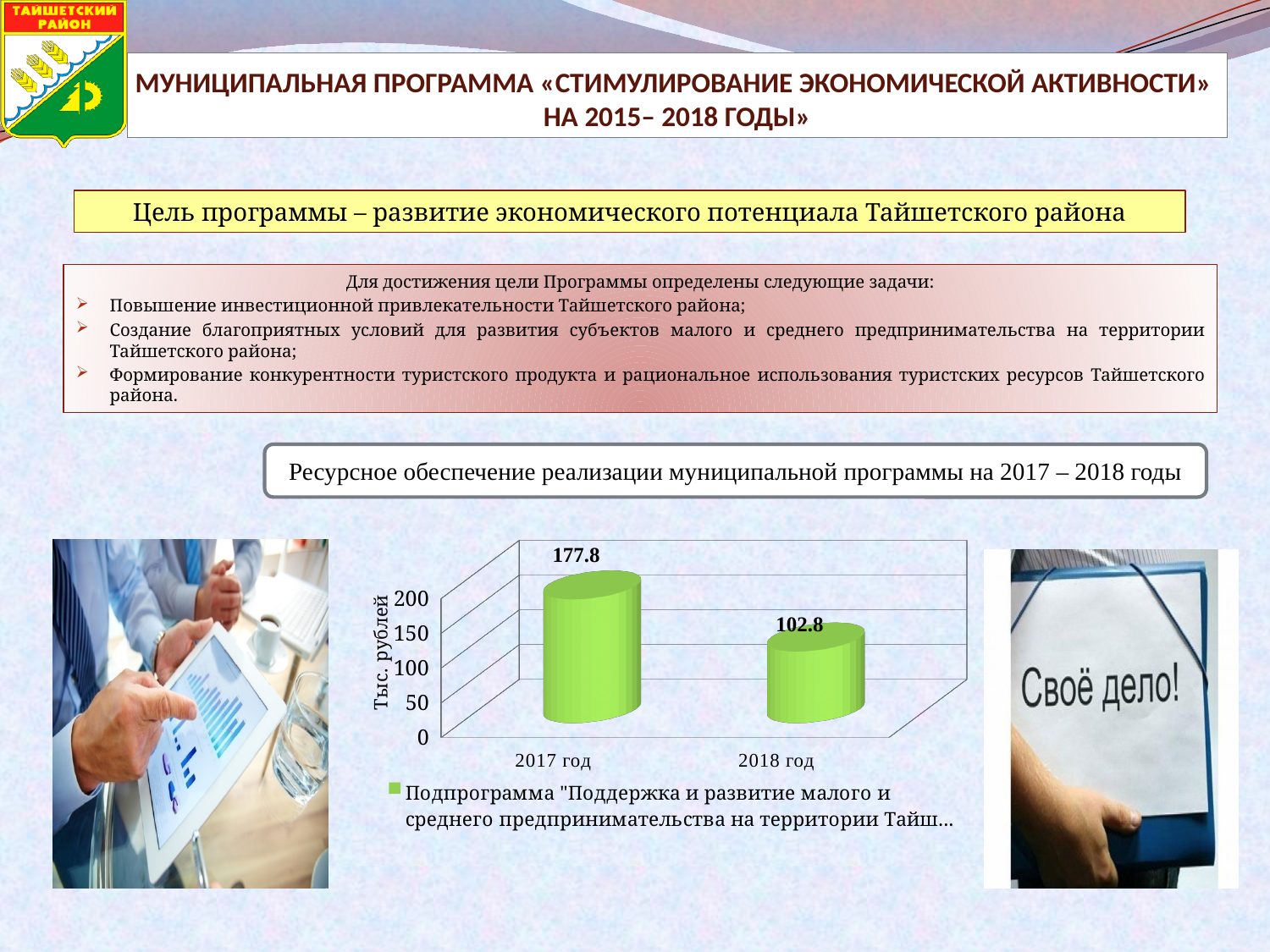
Which year has the highest value? 2017 год Is the value for 2017 год greater or less than 150? greater Do the values rise or fall from 2017 год to 2018 год? fall What kind of chart is shown on the slide? bar chart Which year has the lowest value? 2018 год Which is larger, the value for 2017 год or for 2018 год? 2017 год What is the difference between the values for 2017 год and 2018 год? 75.0 How many series does the chart legend list? 1 What is the value for 2017 год? 177.8 Is the value for 2018 год greater or less than 150? less What is the value for 2018 год? 102.8 How many categories are shown on the x axis of the chart? 2